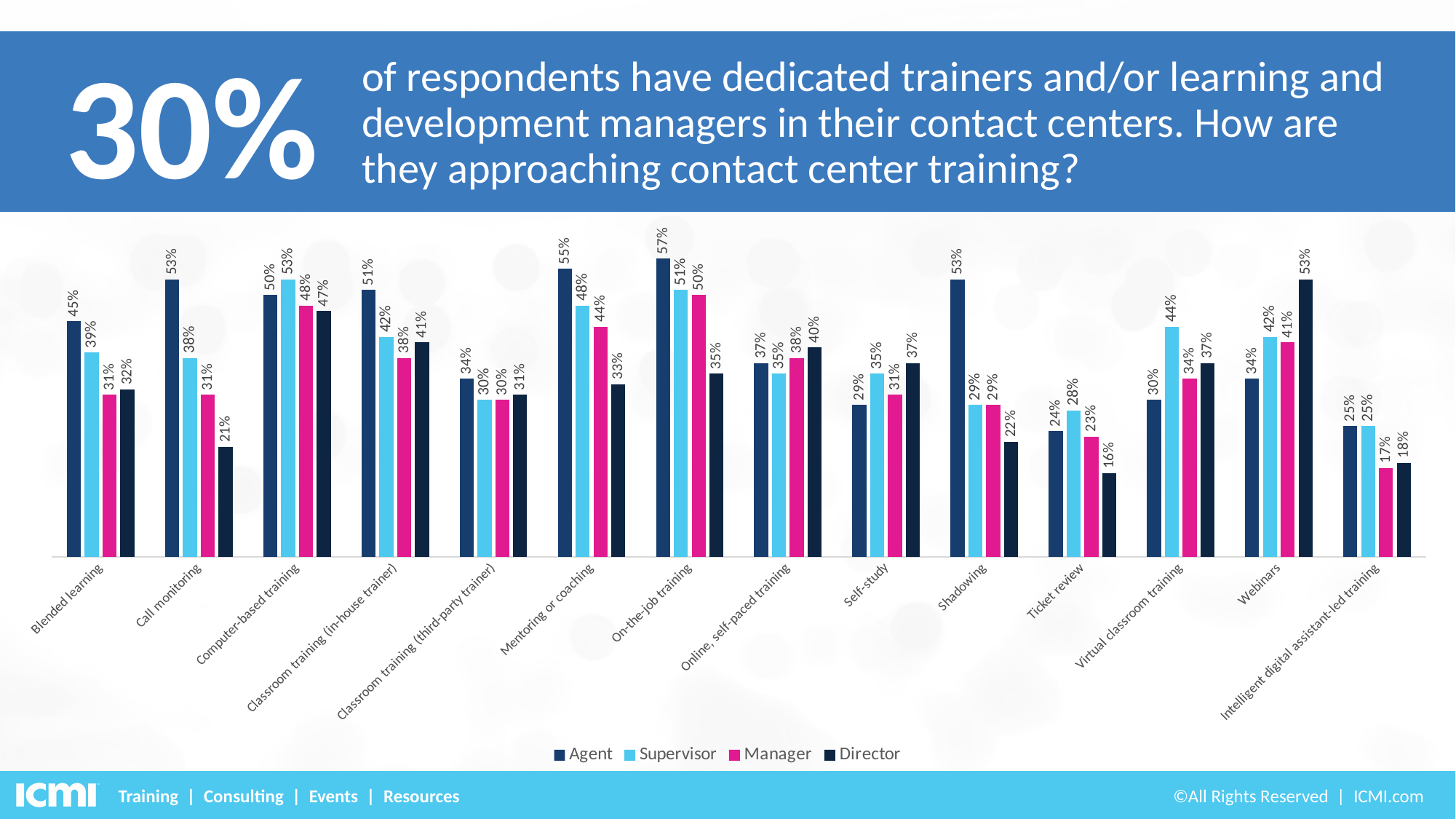
How many series does the legend list? 4 Which series is shown in pink in the legend? Manager What is the Supervisor value for Virtual classroom training? 44% What kind of chart is shown on the slide? Bar chart Which training approach has the lowest Director value? Ticket review What is the Director value for Webinars? 53% What is the difference between the Agent and Director values for Call monitoring? 32 percentage points What is the Manager value for Intelligent digital assistant-led training? 17% What percentage of Agents use on-the-job training? 57% For Shadowing, which is larger: the Agent value or the Supervisor value? Agent How many training approaches are shown on the x axis? 14 Which training approach has the highest Agent value? On-the-job training